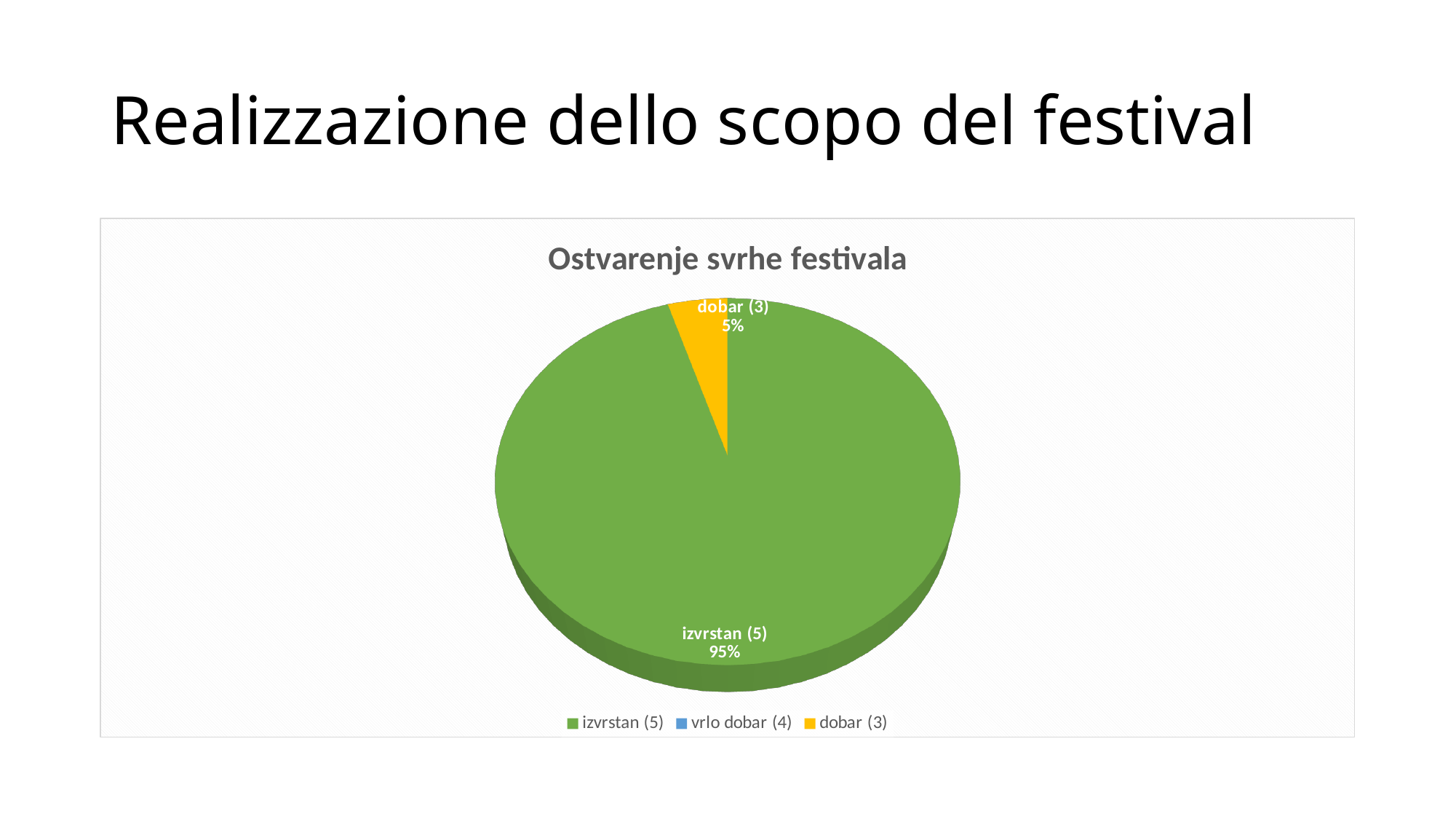
Is the share for dobar (3) greater or less than 10%? less What is the title of the chart? Ostvarenje svrhe festivala What share of the pie does the dobar (3) slice represent? 5% What share of the pie does the izvrstan (5) slice represent? 95% What colour is the izvrstan (5) slice? green What kind of chart is shown on the slide? pie chart Is the share for izvrstan (5) greater or less than 50%? greater What is the difference in percentage points between the izvrstan (5) slice and the dobar (3) slice? 90 How many entries does the legend list? 3 Which of the two labelled slices is larger, izvrstan (5) or dobar (3)? izvrstan (5) Which category has the largest slice of the pie? izvrstan (5)